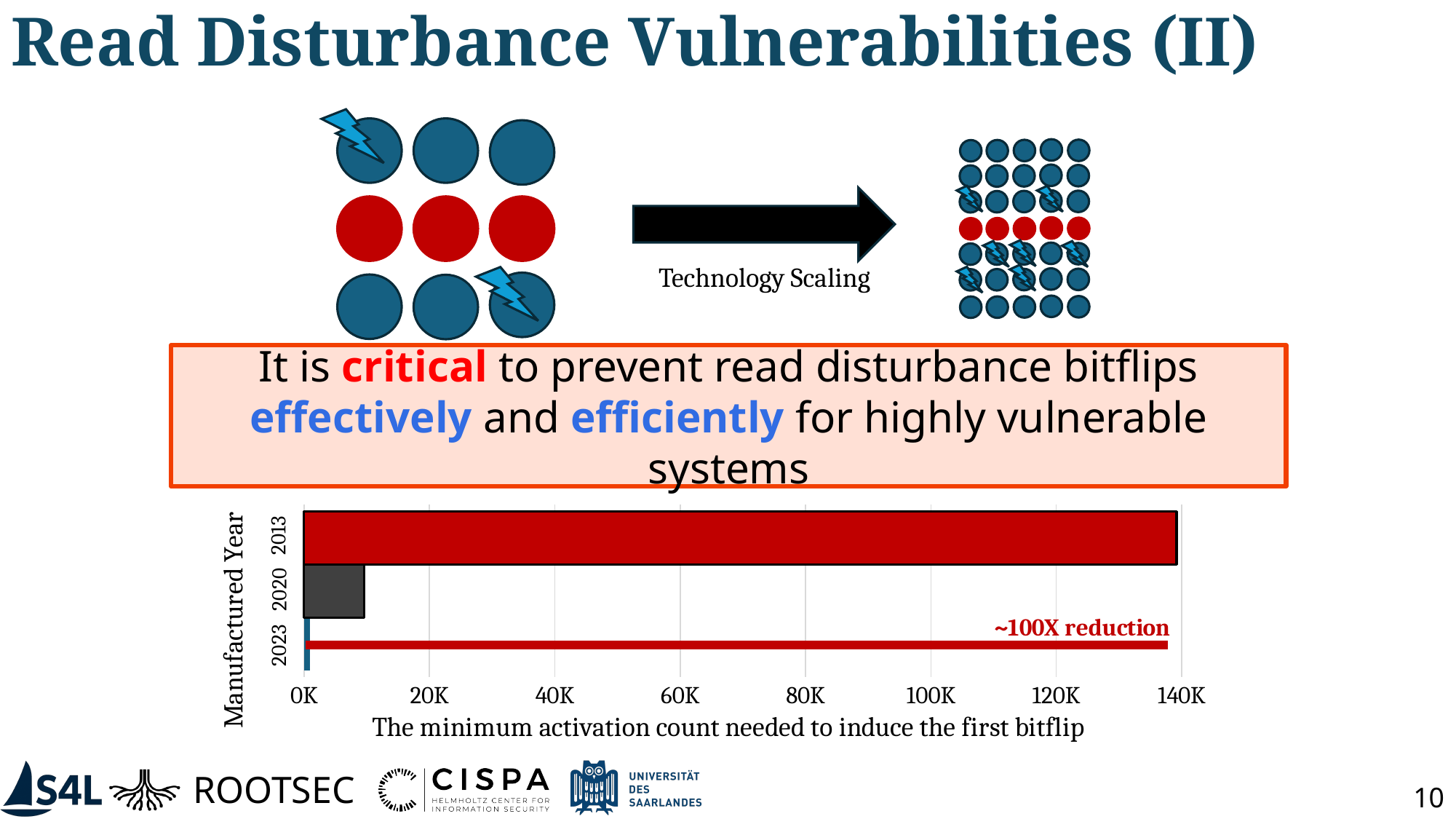
Which has a larger minimum activation count, 2020 or 2023? 2020 Is the minimum activation count for 2023 greater or less than 20K? less What reduction does the annotation on the bar chart state? ~100X reduction How many manufactured years are plotted in the bar chart? 3 Which manufactured year has the lowest minimum activation count in the bar chart? 2023 What is the label of the horizontal axis of the bar chart? The minimum activation count needed to induce the first bitflip Do the minimum activation counts rise or fall as the manufactured year goes from 2013 to 2023? fall Is the minimum activation count for 2020 greater or less than 20K? less Is the minimum activation count for 2013 greater or less than 120K? greater Which manufactured year has the highest minimum activation count in the bar chart? 2013 What kind of chart is shown at the bottom of the slide? bar chart